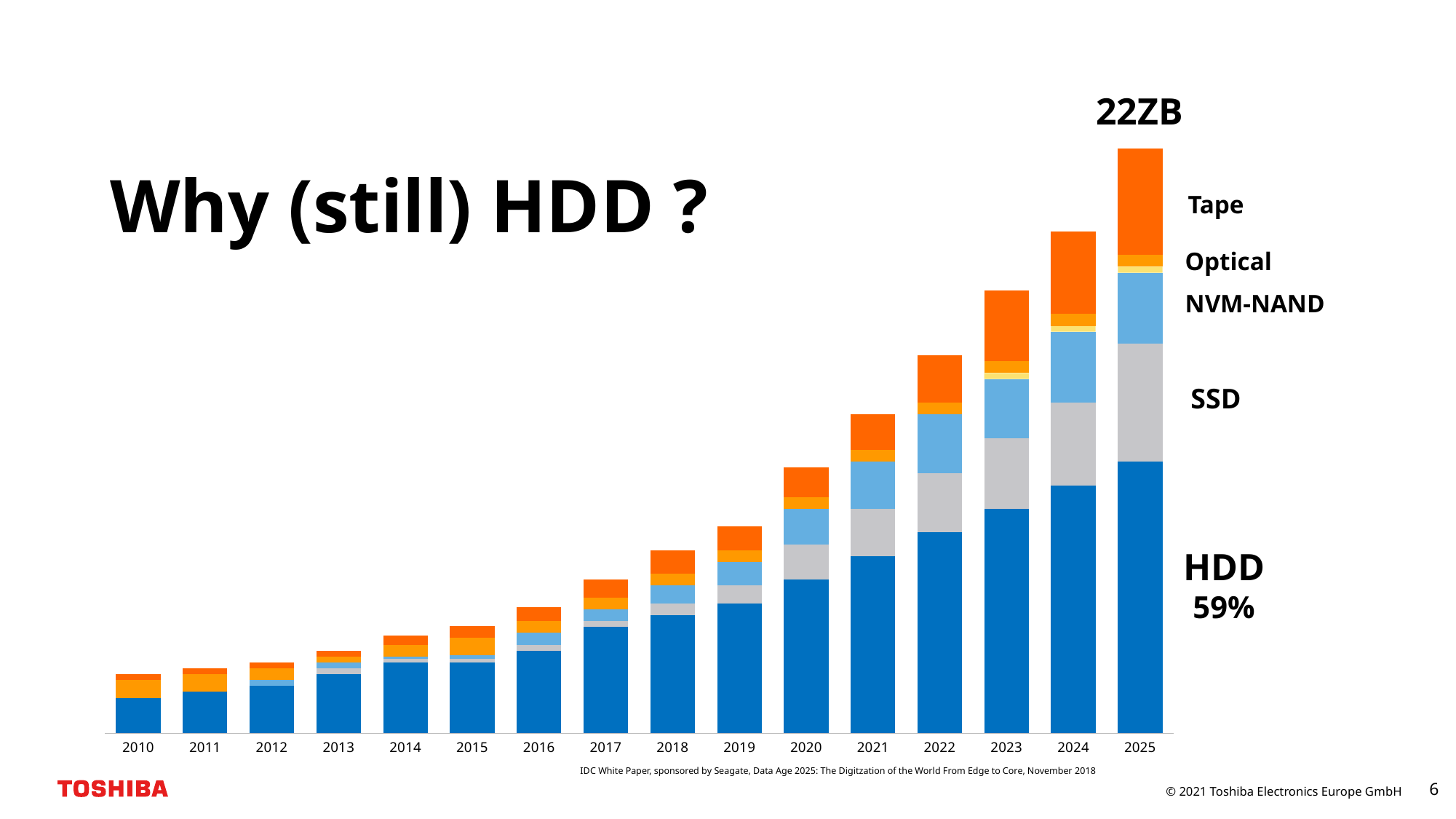
Which series forms the bottom segment of each stacked bar? HDD How many storage media series are labelled on the chart? 5 Which series is labelled at the top of the stacked bars? Tape Which year has the tallest stacked bar? 2025 What kind of chart is shown on the slide? stacked bar chart Which is larger, the stacked bar for 2025 or the stacked bar for 2010? 2025 Do the stacked bar totals rise or fall from 2010 to 2025? rise What share of the 2025 total is labelled for HDD? 59% Which year has the shortest stacked bar? 2010 How many years are shown along the x axis of the chart? 16 What total value is labelled above the 2025 bar? 22ZB What is the title of the slide containing the chart? Why (still) HDD ?